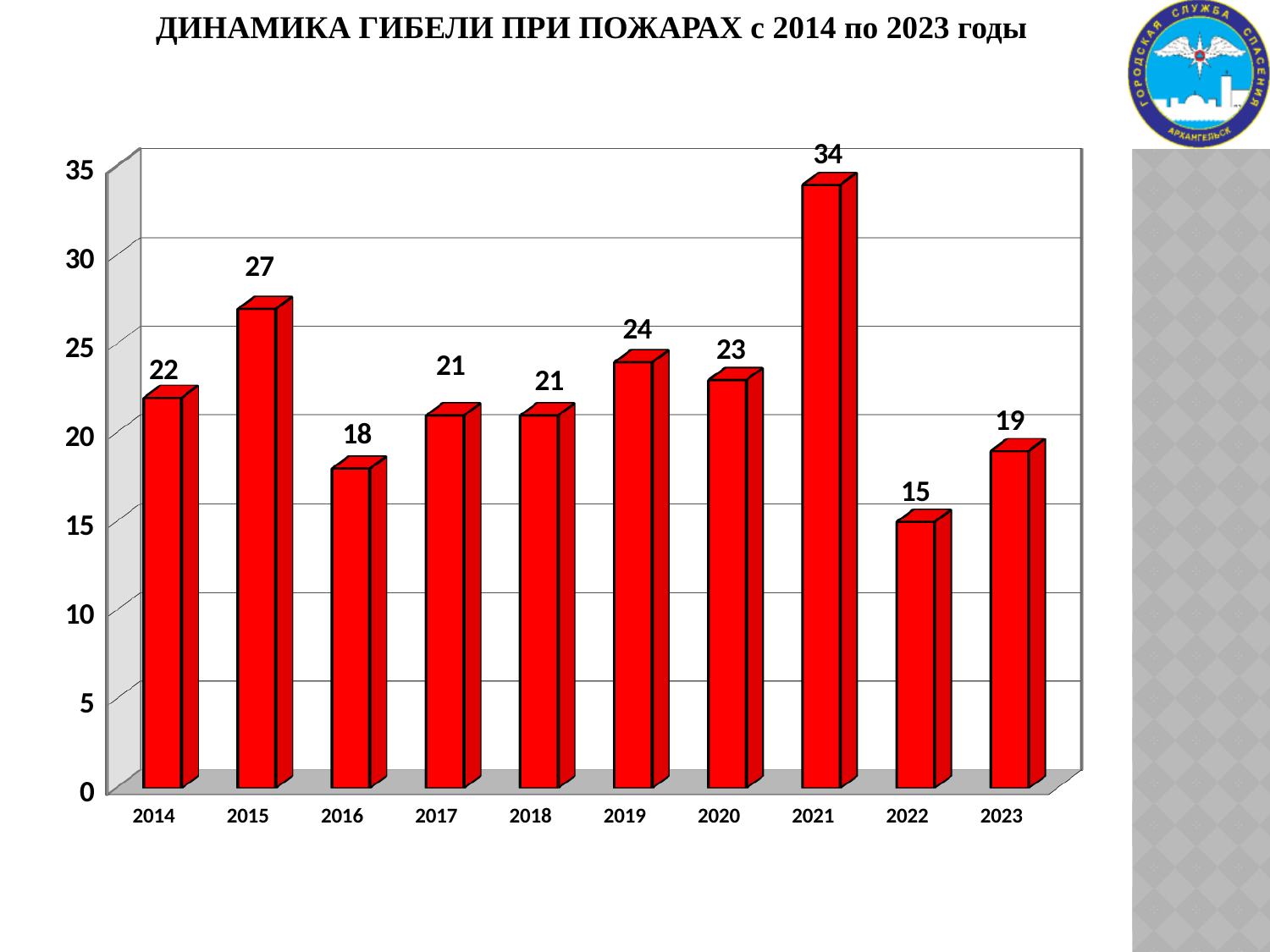
What is the value for 2023? 19 What kind of chart is this? bar chart What is the difference between the values for 2021 and 2022? 19 What is the value for 2021? 34 How many years are shown on the x axis? 10 What is the title of the chart? ДИНАМИКА ГИБЕЛИ ПРИ ПОЖАРАХ с 2014 по 2023 годы Which year has the highest value? 2021 Is the value for 2015 greater or less than 25? greater Which is larger, the value for 2019 or the value for 2020? 2019 Which year has the lowest value? 2022 What is the value for 2016? 18 What is the difference between the values for 2015 and 2014? 5